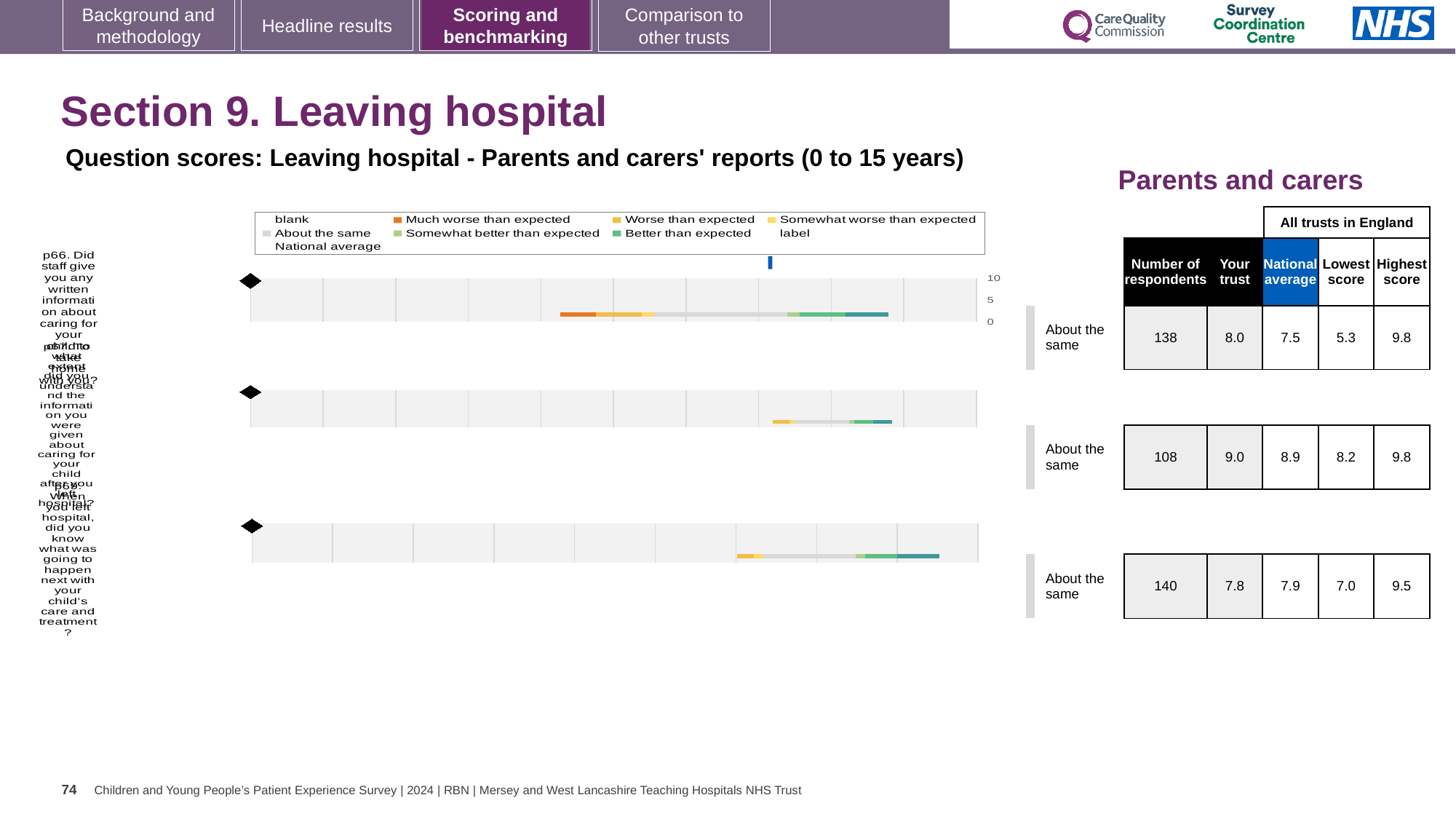
Which question row has the lowest 'Lowest score' value? the first (top) row, 5.3 What is the national average for the second (middle) question row? 8.9 How many respondents are recorded for the third (bottom) question row? 140 In the chart legend, what colour represents 'Much worse than expected'? orange What is the title printed above the chart? Question scores: Leaving hospital - Parents and carers' reports (0 to 15 years) How many question rows (bars) are plotted in the chart? 3 What kind of chart is used to show the question scores on this slide? bar chart Which question row has the highest number of respondents? the third (bottom) row, 140 For the first (top) question row, what is the difference between the highest score and the lowest score? 4.5 For the third (bottom) question row, which is larger: the 'Your trust' score or the national average? national average What benchmark category is shown for each of the three question rows? About the same What is the 'Your trust' score for the first (top) question row? 8.0